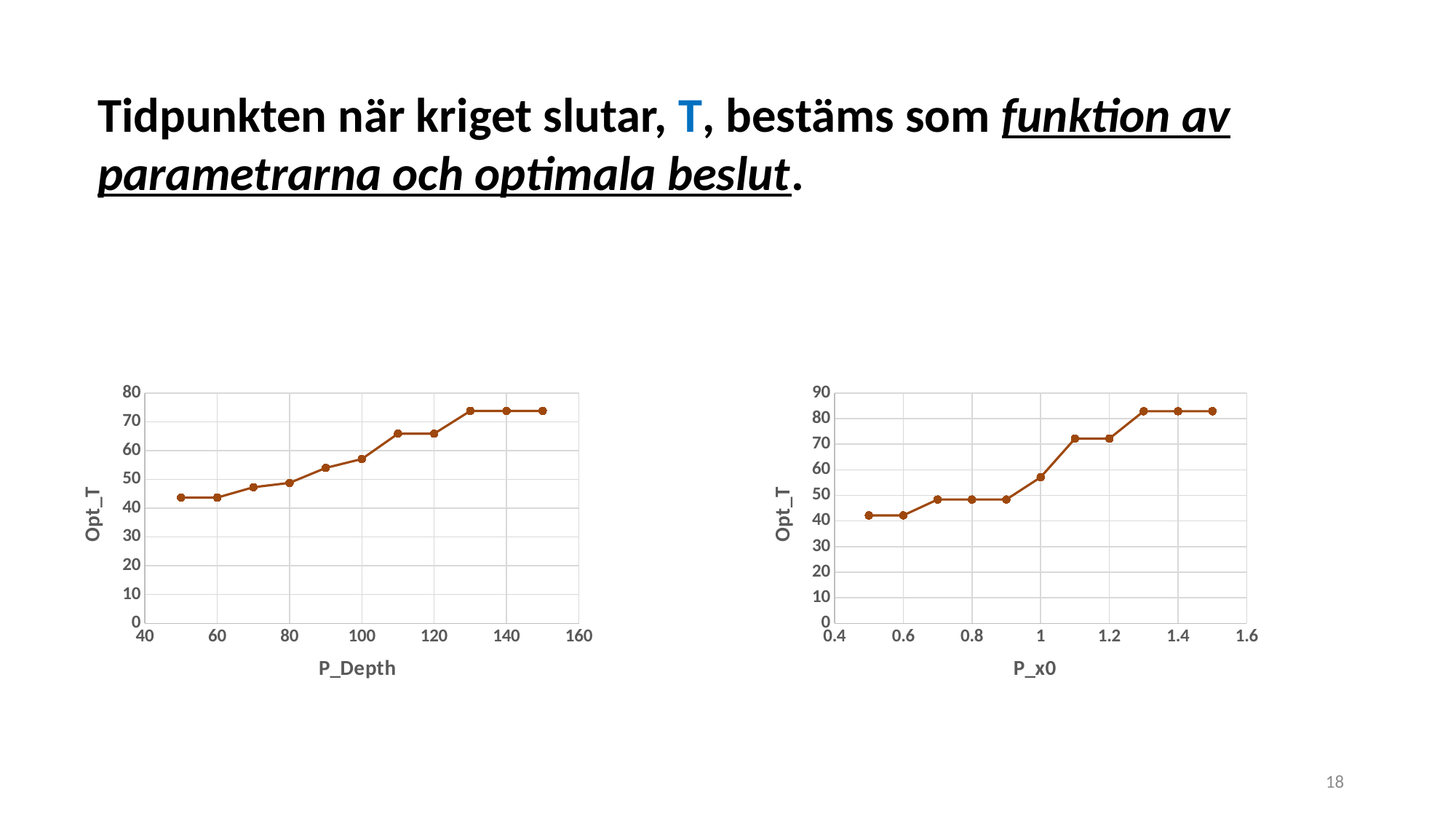
How many data points are plotted on the right chart (P_x0)? 11 On the right chart (P_x0), which has the larger Opt_T value: P_x0 = 1.0 or P_x0 = 1.2? P_x0 = 1.2 On the right chart (P_x0), do the Opt_T values generally rise or fall as P_x0 increases? rise On the right chart (P_x0), is the Opt_T value at P_x0 = 1.5 greater or less than 80? greater On the left chart (P_Depth), is the Opt_T value at P_Depth = 50 greater or less than 40? greater On the left chart (P_Depth), which has the larger Opt_T value: P_Depth = 90 or P_Depth = 130? P_Depth = 130 On the left chart (P_Depth), do the Opt_T values generally rise or fall as P_Depth increases? rise On the left chart (P_Depth), is the Opt_T value at P_Depth = 150 greater or less than 70? greater How many data points are plotted on the left chart (P_Depth)? 11 What is the y-axis label on the right chart? Opt_T What kind of chart is the left chart with x axis P_Depth? line chart